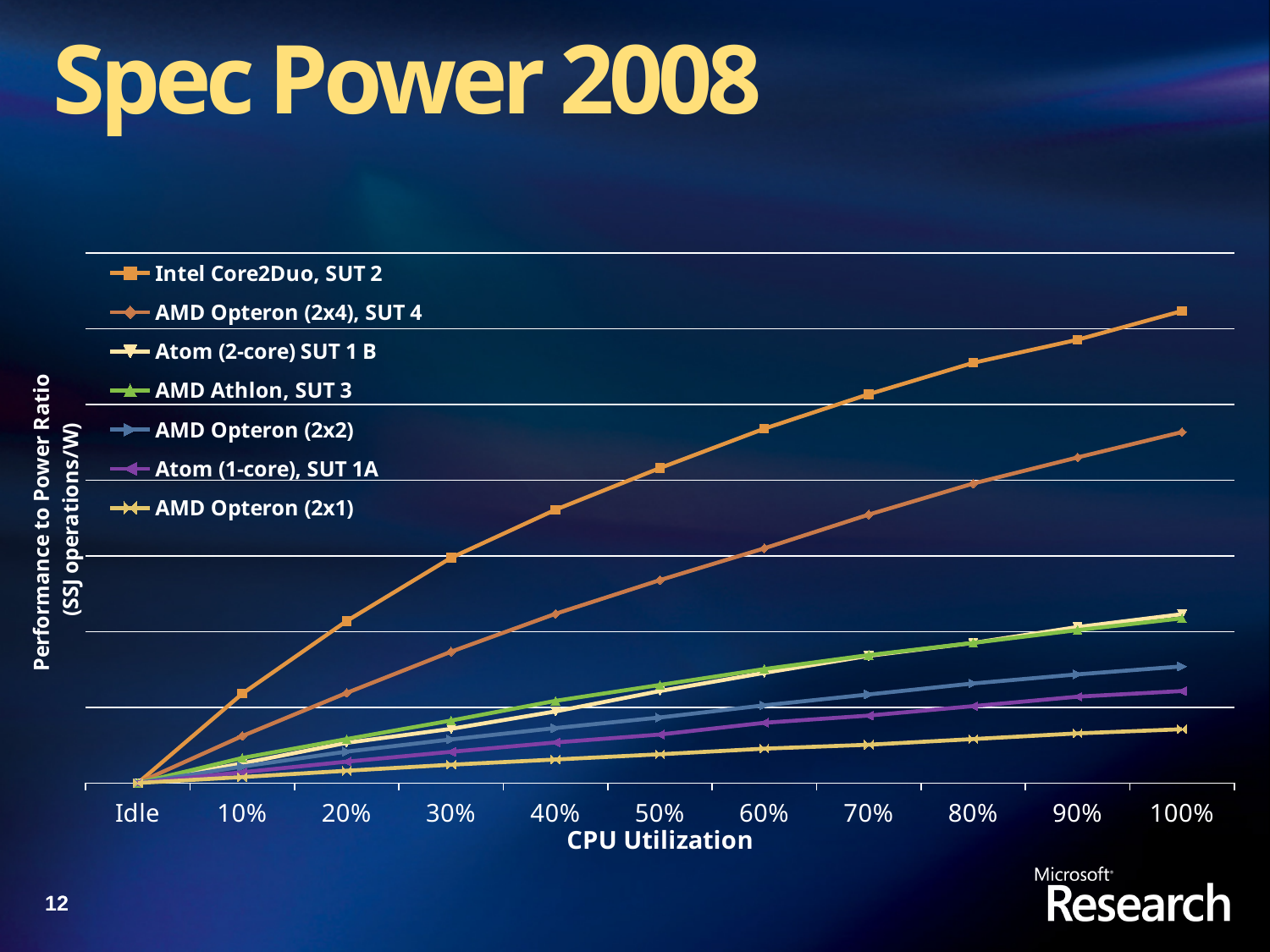
Which series has the lowest performance to power ratio at 100% CPU utilization? AMD Opteron (2x1) At 50% CPU utilization, which is higher: AMD Opteron (2x4), SUT 4 or AMD Athlon, SUT 3? AMD Opteron (2x4), SUT 4 At 30% CPU utilization, which is higher: Intel Core2Duo, SUT 2 or AMD Opteron (2x4), SUT 4? Intel Core2Duo, SUT 2 At 100% CPU utilization, which is higher: AMD Opteron (2x2) or Atom (1-core), SUT 1A? AMD Opteron (2x2) Does the performance to power ratio for Intel Core2Duo, SUT 2 rise or fall as CPU utilization increases from Idle to 100%? Rise What is the label of the x axis? CPU Utilization What kind of chart is shown on the slide? Line chart What is the title of the slide containing the chart? Spec Power 2008 Which series has the second-highest performance to power ratio at 100% CPU utilization? AMD Opteron (2x4), SUT 4 Which series has the highest performance to power ratio at 100% CPU utilization? Intel Core2Duo, SUT 2 How many CPU utilization levels are plotted along the x axis? 11 How many series does the legend list? 7